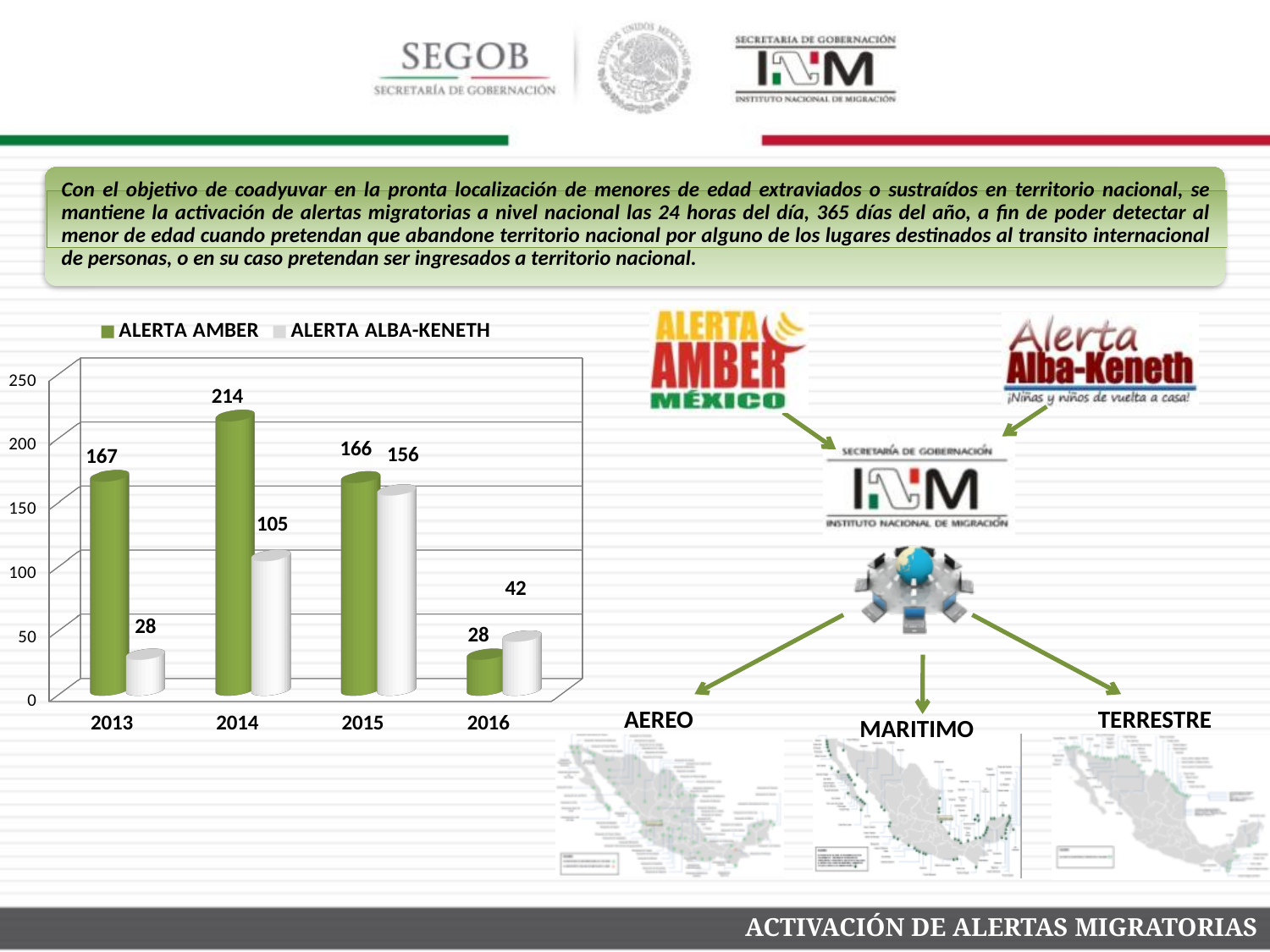
What kind of chart is shown on the slide? Bar chart In which year is the ALERTA ALBA-KENETH value lowest? 2013 Which colour represents ALERTA AMBER in the chart? Green How many series does the chart legend list? 2 How many years are shown on the x axis of the chart? 4 What is the value for ALERTA ALBA-KENETH in 2015? 156 What is the value for ALERTA ALBA-KENETH in 2013? 28 What is the difference between ALERTA AMBER and ALERTA ALBA-KENETH in 2014? 109 Does the ALERTA ALBA-KENETH value rise or fall from 2015 to 2016? Fall In which year is the ALERTA AMBER value highest? 2014 Which is larger in 2016, ALERTA AMBER or ALERTA ALBA-KENETH? ALERTA ALBA-KENETH What is the value for ALERTA AMBER in 2014? 214